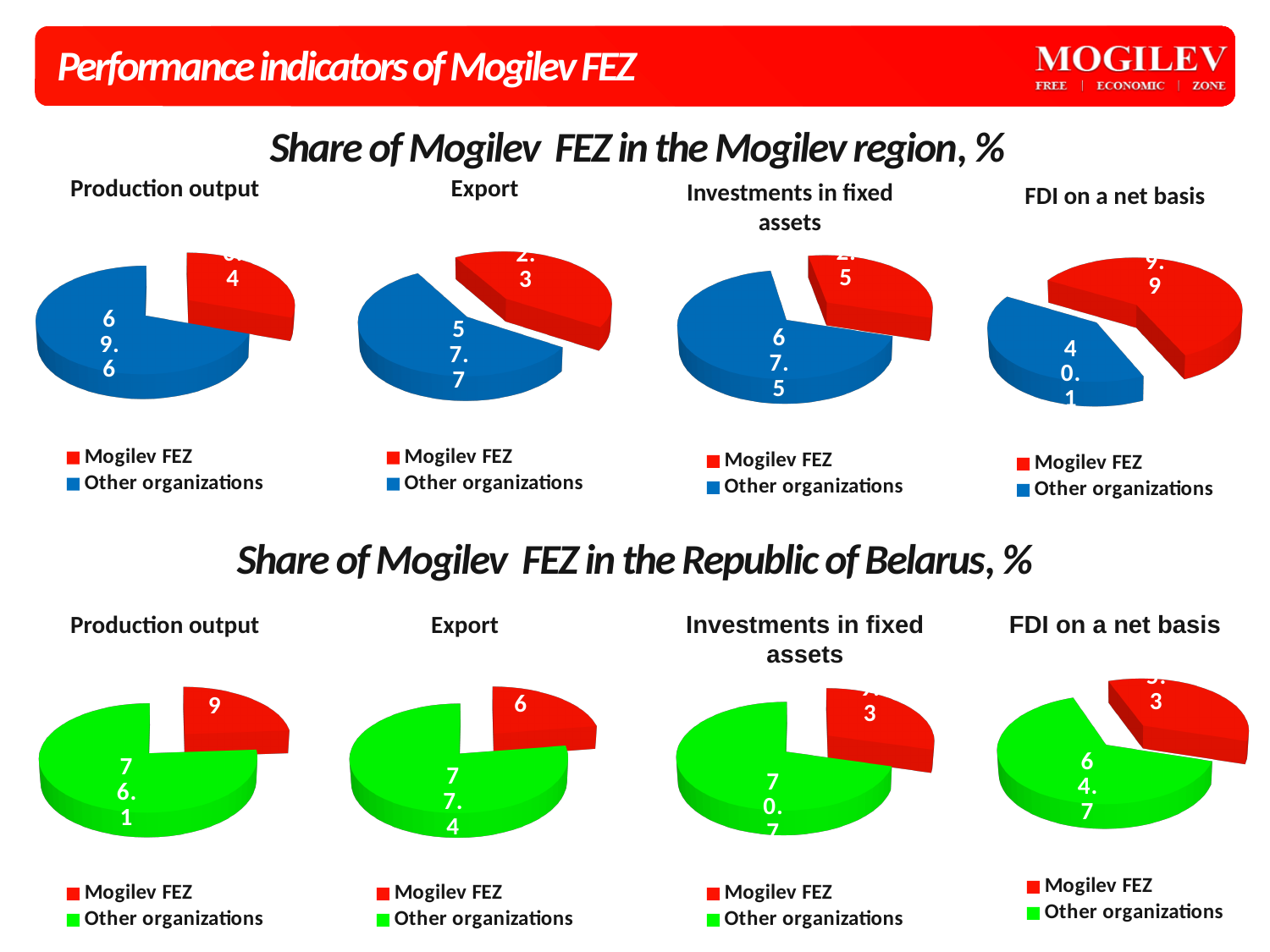
In the bottom row of charts ('Share of Mogilev FEZ in the Republic of Belarus, %'), what colour represents Other organizations? Green In the 'Share of Mogilev FEZ in the Mogilev region, %' Production output chart, what is the value for Other organizations? 69.6 In the 'Share of Mogilev FEZ in the Mogilev region, %' FDI on a net basis chart, which slice is larger: Mogilev FEZ or Other organizations? Mogilev FEZ What kind of chart is used for the Production output chart in the top row? Pie chart In the 'Share of Mogilev FEZ in the Mogilev region, %' FDI on a net basis chart, what is the value for Other organizations? 40.1 In the 'Share of Mogilev FEZ in the Republic of Belarus, %' FDI on a net basis chart, what is the value for Other organizations? 64.7 In the 'Share of Mogilev FEZ in the Mogilev region, %' Export chart, what is the value for Other organizations? 57.7 In the 'Share of Mogilev FEZ in the Republic of Belarus, %' Export chart, which slice is larger: Mogilev FEZ or Other organizations? Other organizations In the 'Share of Mogilev FEZ in the Republic of Belarus, %' Export chart, what is the value for Other organizations? 77.4 In the 'Share of Mogilev FEZ in the Republic of Belarus, %' Production output chart, what is the value for Other organizations? 76.1 In the 'Share of Mogilev FEZ in the Mogilev region, %' Investments in fixed assets chart, what is the value for Other organizations? 67.5 How many entries does the legend of the 'Share of Mogilev FEZ in the Mogilev region, %' Export chart list? 2